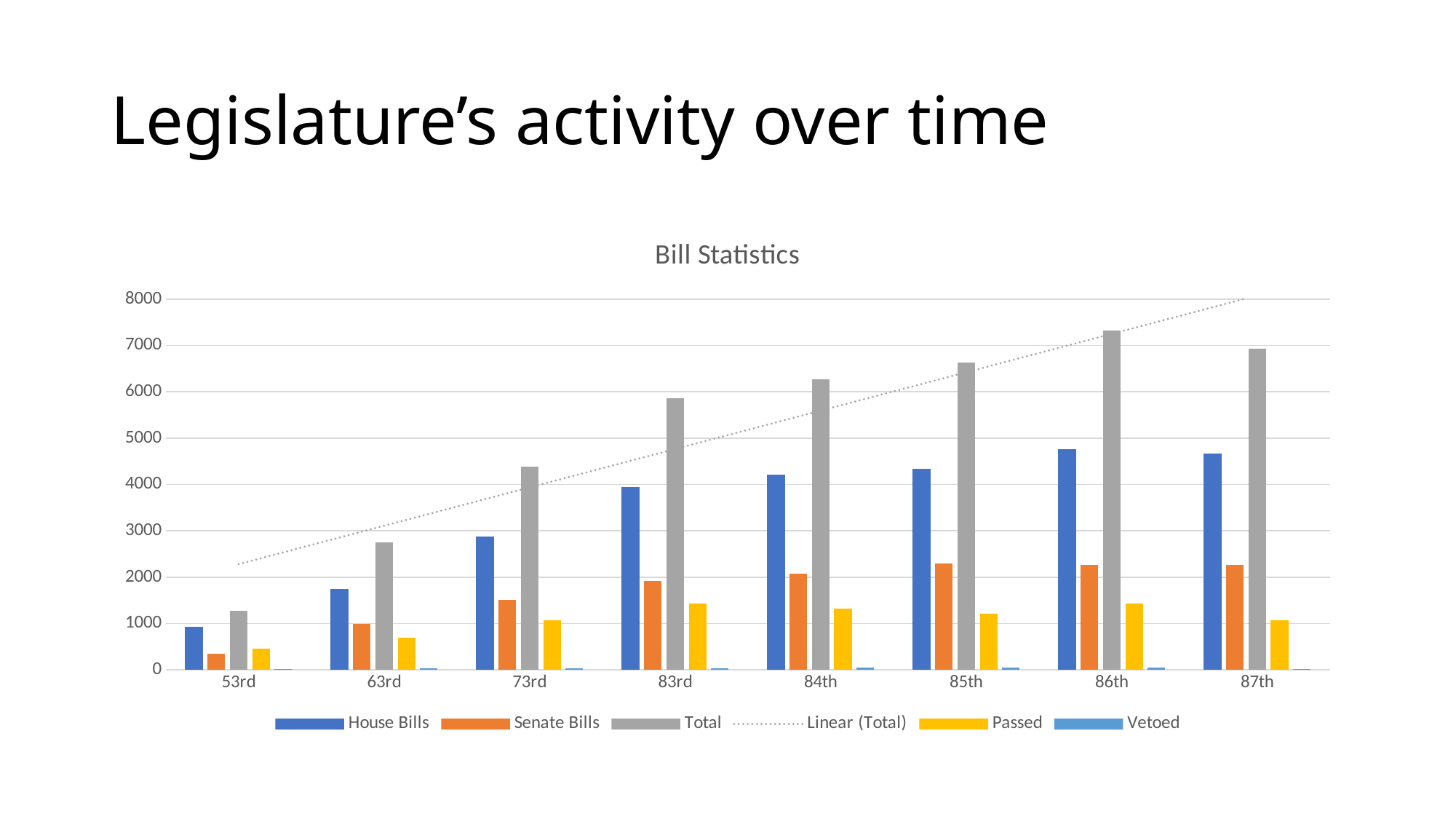
Is the Senate Bills value for the 53rd session greater or less than 1000? less What is the title of the chart? Bill Statistics Which is larger, the Passed value for the 85th session or for the 86th session? 86th What kind of chart is shown on the slide? bar chart Is the Total value for the 86th session greater or less than 7000? greater How many legislative sessions (categories) are shown on the x axis? 8 How many series does the legend list? 6 Is the Total value for the 83rd session greater or less than 5000? greater Does the Total series generally rise or fall from the 53rd session to the 86th session? rise Which session has the highest Total value? 86th Which session has the lowest Total value? 53rd Which session has the lowest Passed value? 53rd